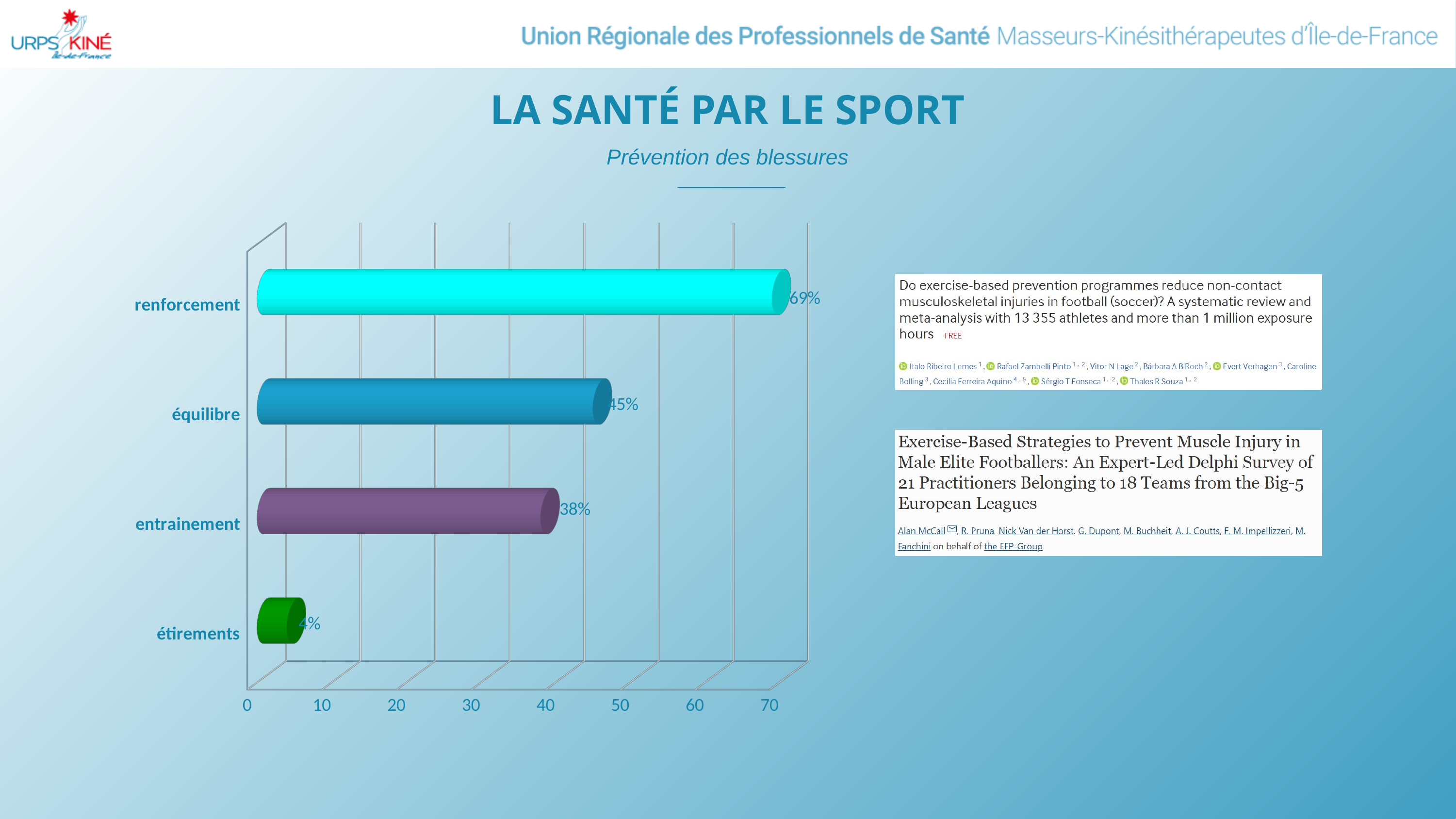
What kind of chart is shown on the slide? bar chart What is the value for renforcement? 69% Is the value for entrainement greater or less than 30? greater Which category has the highest value? renforcement How many categories are shown in the chart? 4 What is the difference between the values for entrainement and étirements? 34% Which category has the lowest value? étirements What is the value for équilibre? 45% What is the difference between the values for renforcement and équilibre? 24% Which is larger, the value for équilibre or the value for entrainement? équilibre What is the value for étirements? 4% What is the value for entrainement? 38%